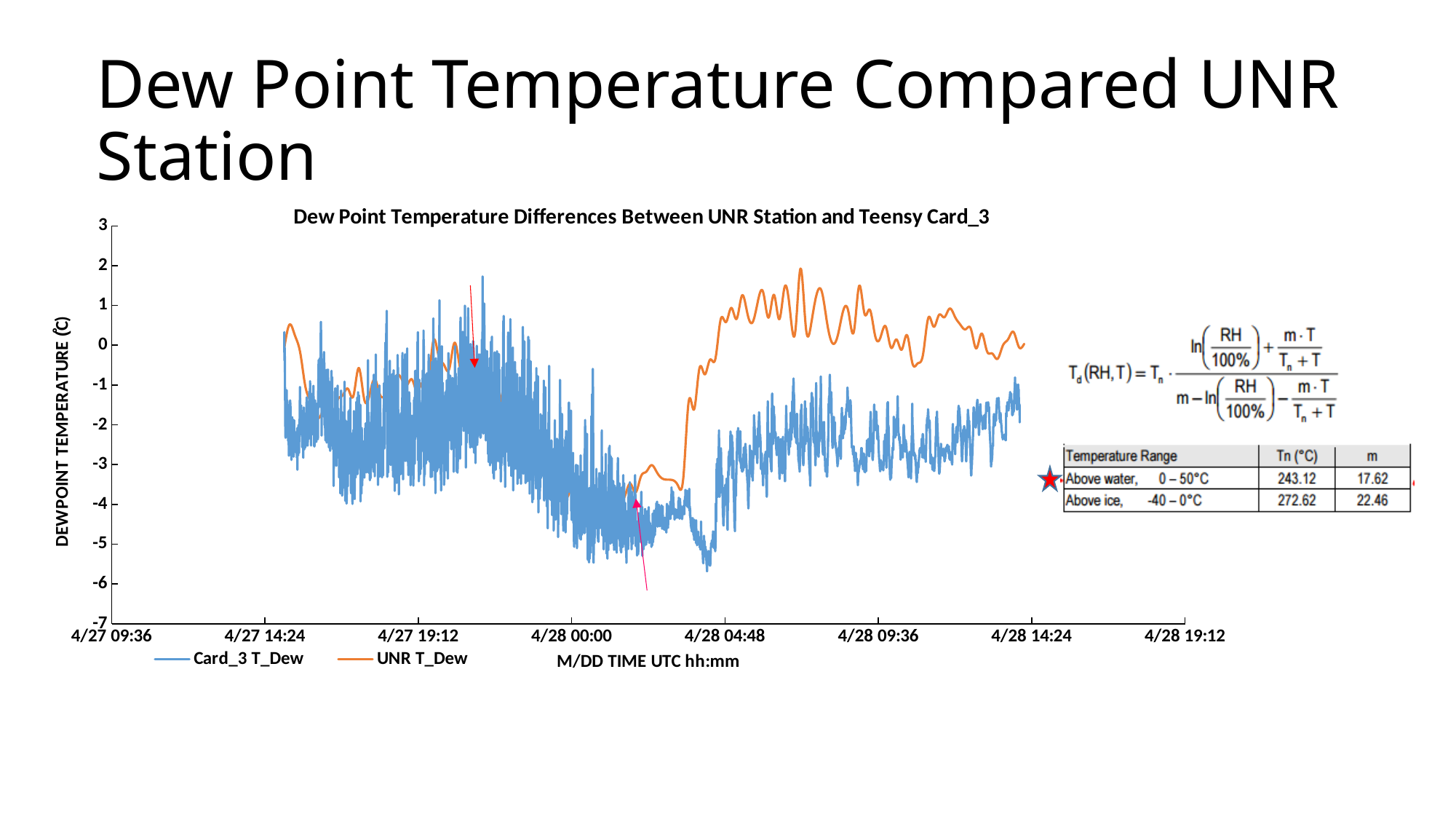
What are the two series named in the chart's legend? Card_3 T_Dew and UNR T_Dew Is the UNR T_Dew value at 4/28 09:36 greater or less than 0? greater Is the UNR T_Dew value at 4/27 19:12 greater or less than 0? less Is the UNR T_Dew value at 4/28 04:48 greater or less than -2? greater What kind of chart is shown on the slide? Line chart Does the UNR T_Dew series rise or fall between 4/28 00:00 and 4/28 04:48? Rise Does the Card_3 T_Dew series generally rise or fall between 4/27 19:12 and 4/28 00:00? Fall At 4/28 09:36, which series has the higher value, Card_3 T_Dew or UNR T_Dew? UNR T_Dew How many series does the chart's legend list? 2 What is the title of the chart? Dew Point Temperature Differences Between UNR Station and Teensy Card_3